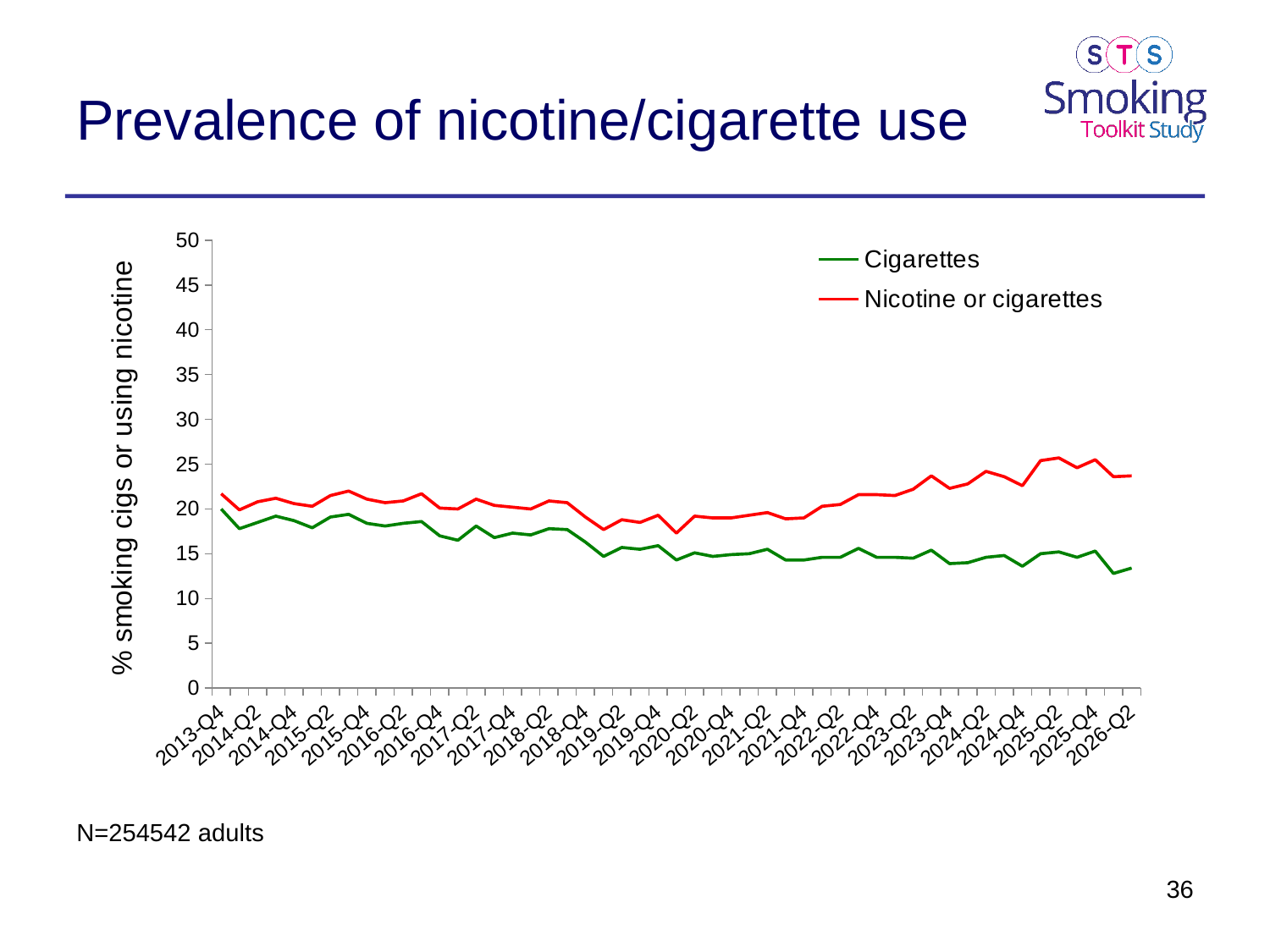
Which series has the higher value at 2025-Q2, Cigarettes or Nicotine or cigarettes? Nicotine or cigarettes Does the Nicotine or cigarettes series generally rise or fall from 2020-Q2 to 2025-Q2? rise How many series does the legend list? 2 Is the value for Cigarettes at 2024-Q4 greater or less than 15? less What kind of chart is shown on the slide? line chart Does the Cigarettes series generally rise or fall from 2013-Q4 to 2026-Q2? fall What is the label on the vertical axis? % smoking cigs or using nicotine Is the value for Nicotine or cigarettes at 2023-Q4 greater or less than 20? greater Is the value for Cigarettes at 2026-Q2 greater or less than 15? less Which series is drawn in red? Nicotine or cigarettes